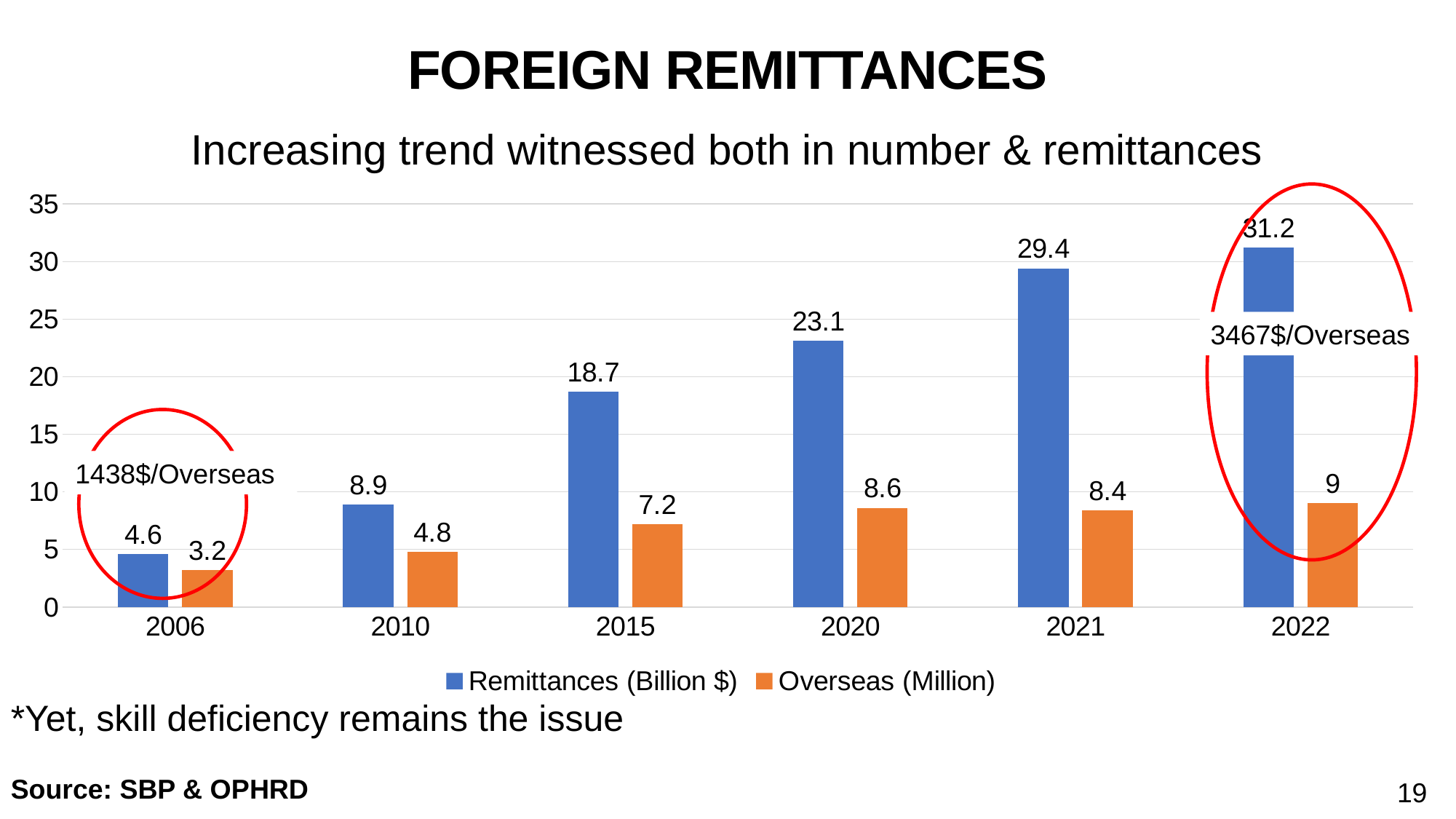
Which year has the highest Remittances (Billion $) value? 2022 What is the value of Overseas (Million) for 2020? 8.6 What is the difference between the Remittances (Billion $) values for 2021 and 2020? 6.3 How many series does the legend list? 2 Do the Remittances (Billion $) values rise or fall from 2006 to 2022? rise Is the Remittances (Billion $) value for 2020 greater or less than 20? greater What is the value of Remittances (Billion $) for 2015? 18.7 What is the value of Remittances (Billion $) for 2022? 31.2 Which is larger, the Overseas (Million) value for 2021 or for 2022? 2022 What kind of chart is shown on the slide? bar chart Which year has the lowest Overseas (Million) value? 2006 How many years are shown on the x axis? 6